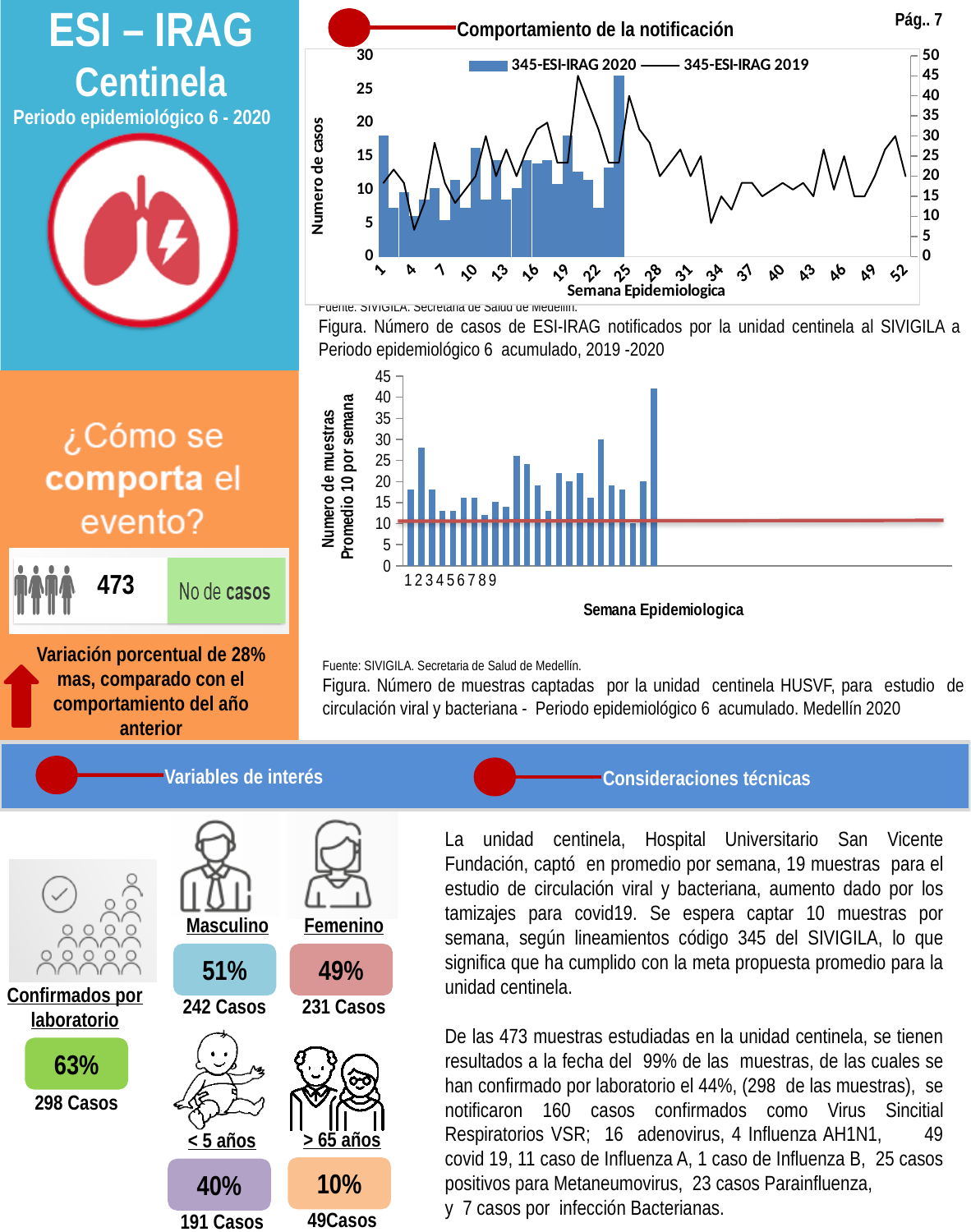
In the top chart 'Comportamiento de la notificación', is the 2020 bar for week 4 greater or less than 15? less In the top chart 'Comportamiento de la notificación', is the 2020 bar for week 1 greater or less than 15? greater In the bottom chart 'Numero de muestras Promedio 10 por semana', is the tallest bar greater or less than 40? greater In the top chart 'Comportamiento de la notificación', which series is drawn as bars? 345-ESI-IRAG 2020 In the top chart 'Comportamiento de la notificación', which week has the highest 2020 bar? 24 What kind of chart is the top chart titled 'Comportamiento de la notificación'? A combined bar and line chart In the top chart 'Comportamiento de la notificación', what is the title of the x axis? Semana Epidemiologica What kind of chart is the bottom chart with the y axis 'Numero de muestras Promedio 10 por semana'? Bar chart How many series does the legend of the top chart 'Comportamiento de la notificación' list? 2 In the bottom chart 'Numero de muestras Promedio 10 por semana', what is the highest value shown on the y axis? 45